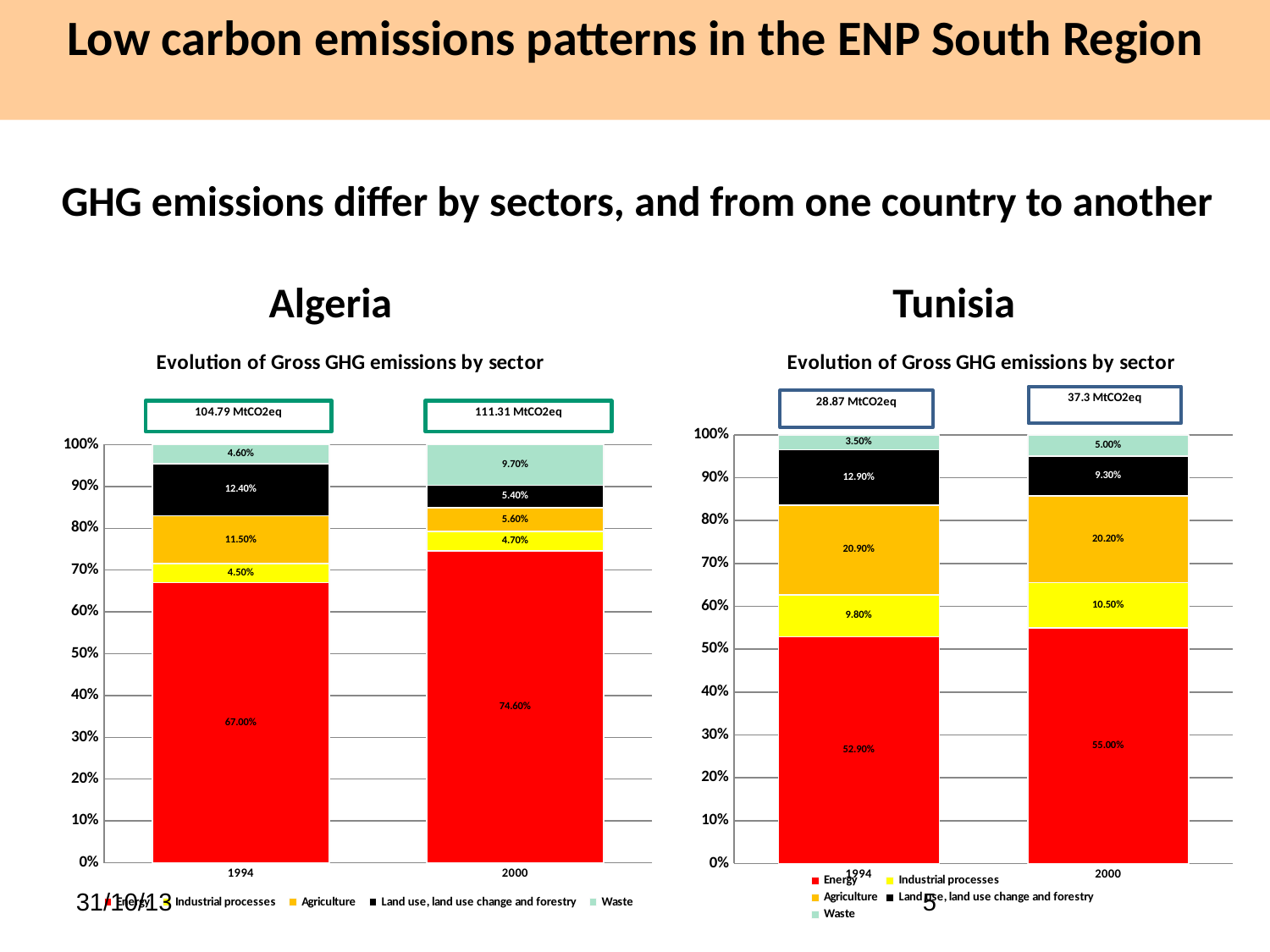
In the Algeria chart, what is the Waste share in 2000? 9.70% How many series does the legend of the Tunisia chart list? 5 In the Algeria chart, what share of emissions did Energy account for in 1994? 67.00% In the Algeria chart, which sector has the largest share in 2000? Energy In the Tunisia chart, what is the Energy share in 2000? 55.00% What total emissions value is shown above the 2000 bar in the Tunisia chart? 37.3 MtCO2eq In the Algeria chart, by how many percentage points did the Energy share change from 1994 to 2000? 7.60 percentage points What kind of chart is used for Algeria? Stacked bar chart In the Tunisia chart, which sector has the smallest share in 1994? Waste How many years are shown on the x axis of the Algeria chart? 2 In the Tunisia chart, is the Agriculture share larger in 1994 or in 2000? 1994 In the Tunisia chart, what share did Agriculture have in 1994? 20.90%